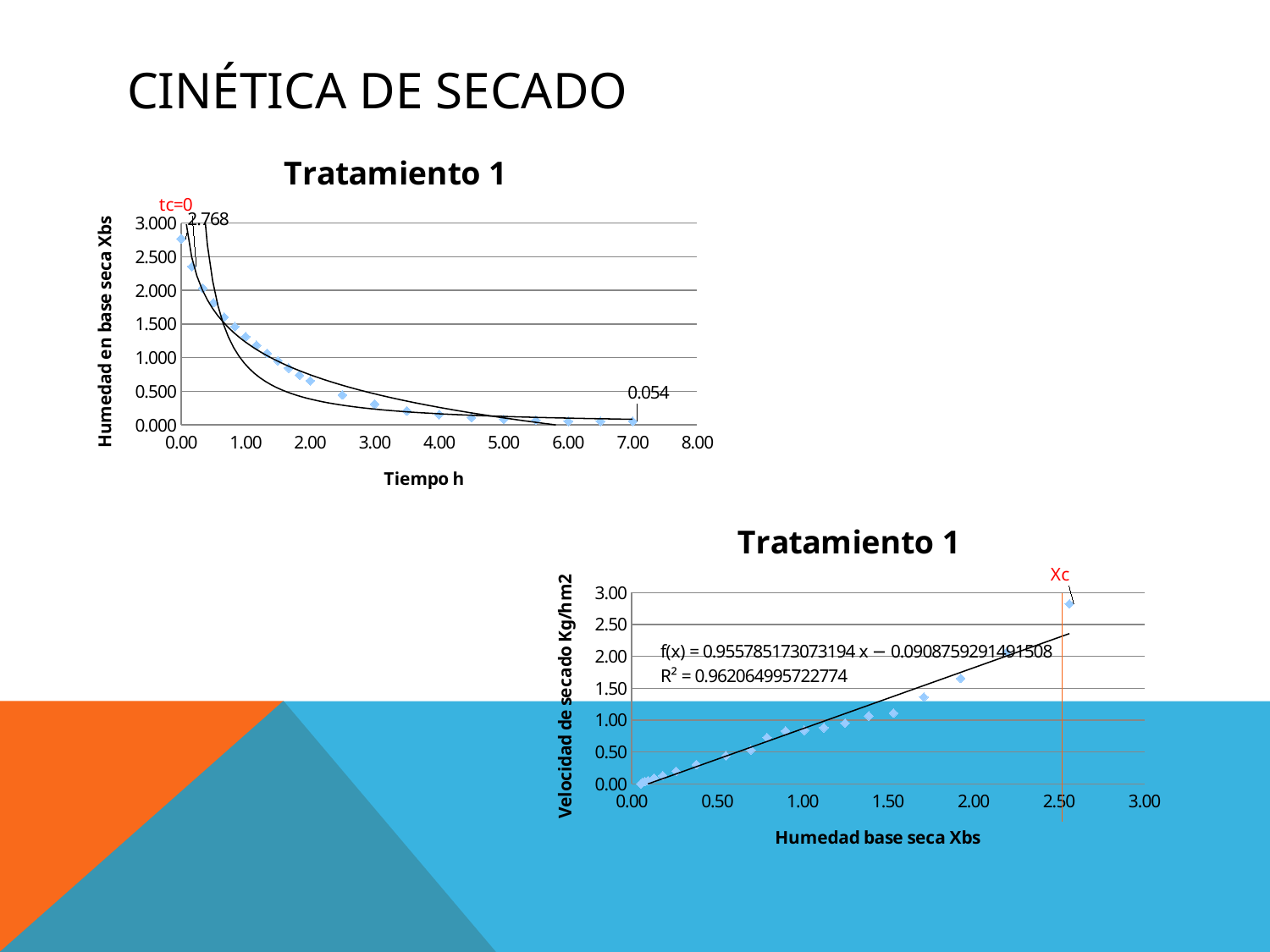
In the top chart, what is the data label shown at the first point near time 0.00 h? 2.768 In the bottom chart, is the highest plotted drying rate greater or less than 2.50? greater In the top chart, what is the difference between the labelled values 2.768 and 0.054? 2.714 What is the title of the x axis of the top chart? Tiempo h In the top chart, what is the data label shown at the point near 7.00 h? 0.054 What is the title of the y axis of the bottom chart? Velocidad de secado Kg/hm2 In the bottom chart, what R² value is printed for the fitted line? R² = 0.962064995722774 In the top chart, is the value at 3.00 h greater or less than 0.500? less In the top chart, which is larger: the value at 1.00 h or the value at 2.00 h? 1.00 h What kind of chart is the top chart on the slide? Scatter chart In the top chart, do the plotted values rise or fall as time increases? Fall In the bottom chart, do the plotted values rise or fall as Humedad base seca Xbs increases? Rise